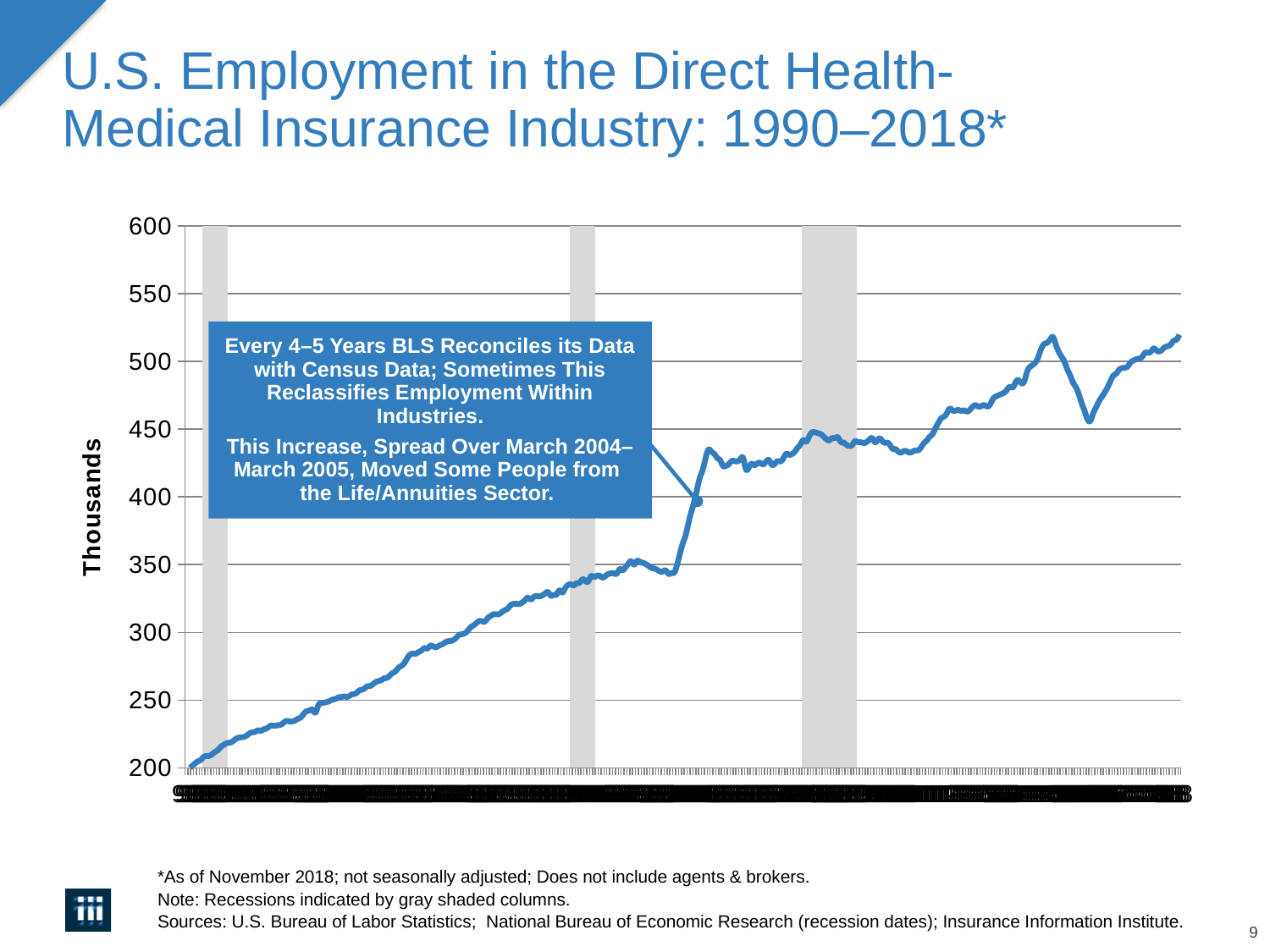
According to the note, what do the gray shaded columns indicate? Recessions Is the lowest point of the line greater or less than 250? less Is the highest point reached by the line greater or less than 550? less What kind of chart is shown on the slide? line chart Is the value at the end of the line (right end) greater or less than 500? greater What is the label on the vertical axis? Thousands Overall, do the values rise or fall from the left of the chart to the right? rise